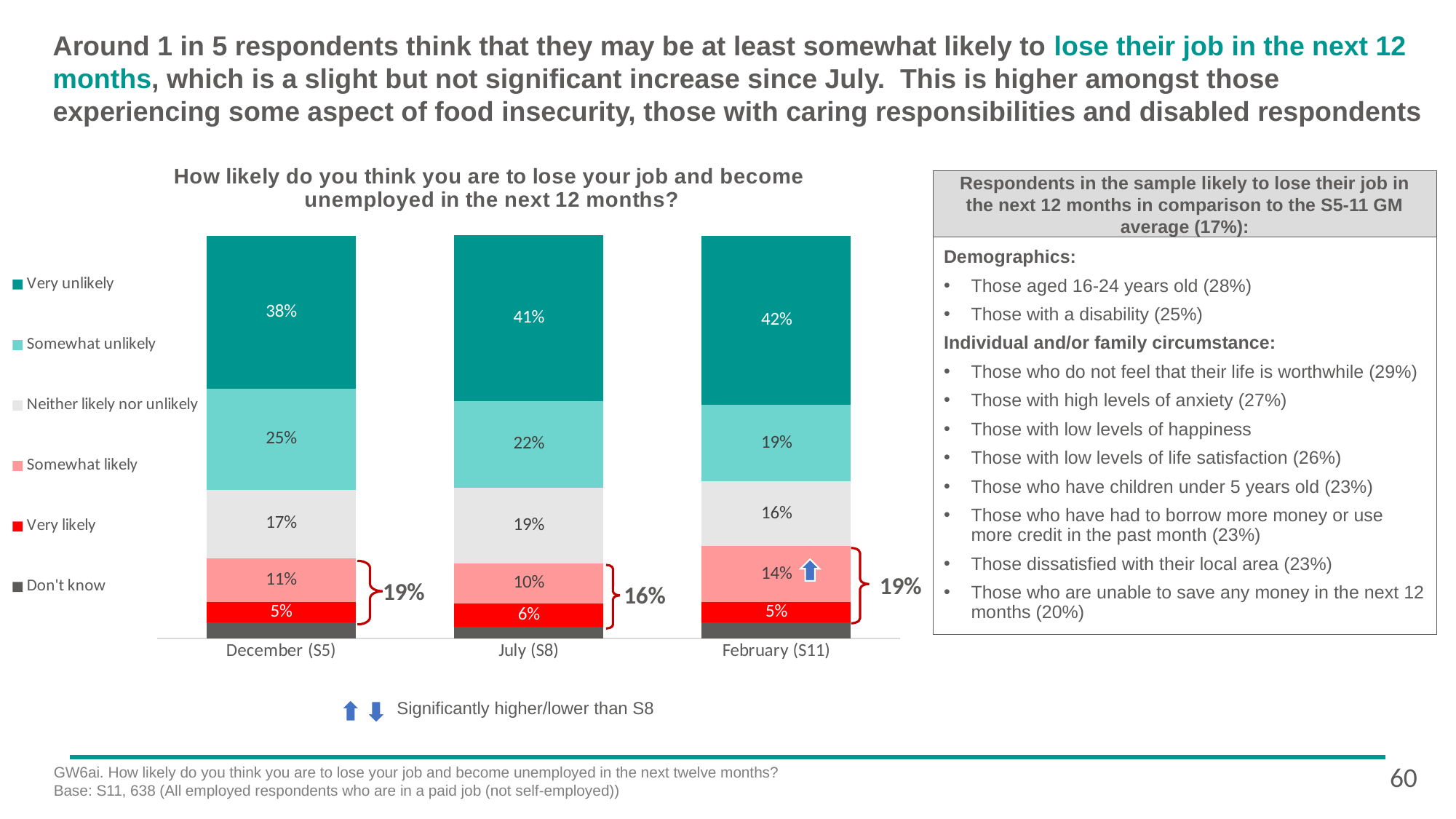
How many survey waves are shown on the x axis of the chart? 3 In which survey wave was the 'Somewhat unlikely' share the lowest? February (S11) What percentage of respondents said 'Somewhat likely' in July (S8)? 10% What type of chart is used to show how likely respondents think they are to lose their job? Stacked bar chart In which survey wave was the 'Very unlikely' share the highest? February (S11) How many series does the chart legend list? 6 What percentage of respondents said 'Neither likely nor unlikely' in December (S5)? 17% What is the combined share of 'Somewhat likely' and 'Very likely' respondents in July (S8), as shown by the bracket? 16% What percentage of respondents said 'Very likely' in July (S8)? 6% What is the difference between the 'Somewhat likely' share in February (S11) and in July (S8)? 4 percentage points Which is larger: the 'Somewhat unlikely' share in December (S5) or in July (S8)? December (S5) What percentage of respondents said 'Very unlikely' in February (S11)? 42%